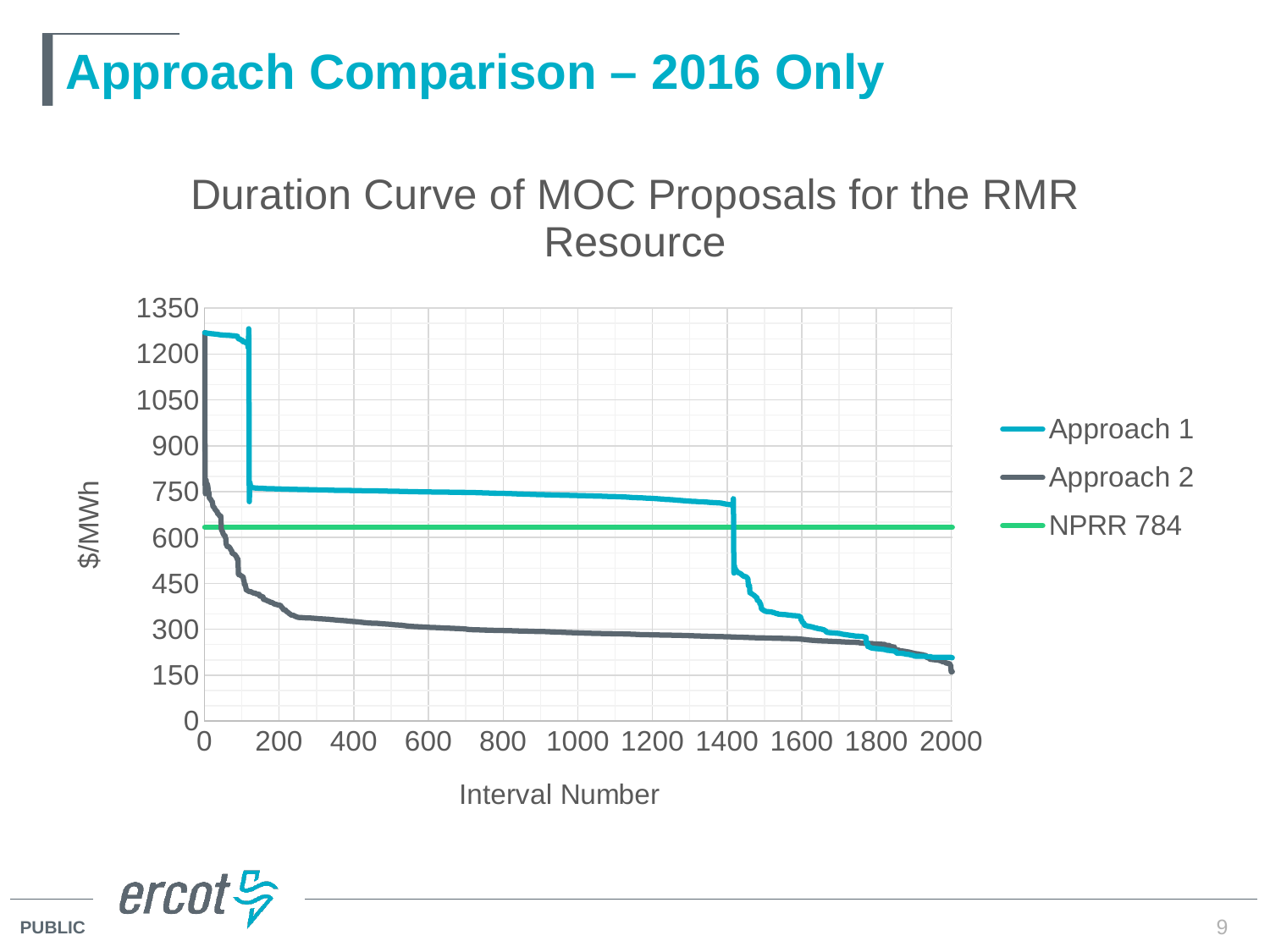
Do the values for Approach 1 rise or fall as the interval number increases? Fall What is the title of the chart? Duration Curve of MOC Proposals for the RMR Resource What is the label of the x axis? Interval Number At interval number 600, which series has the lower value, Approach 1 or Approach 2? Approach 2 How many series does the legend list? 3 Is the value for Approach 1 at interval number 1000 greater or less than 600? greater What kind of chart is shown on the slide? Line chart At interval number 1000, which series has the higher value, Approach 1 or Approach 2? Approach 1 Is the value for Approach 1 at interval number 1600 greater or less than 450? less Is the value for Approach 2 at interval number 1000 greater or less than 450? less Do the values for Approach 2 rise or fall as the interval number increases? Fall